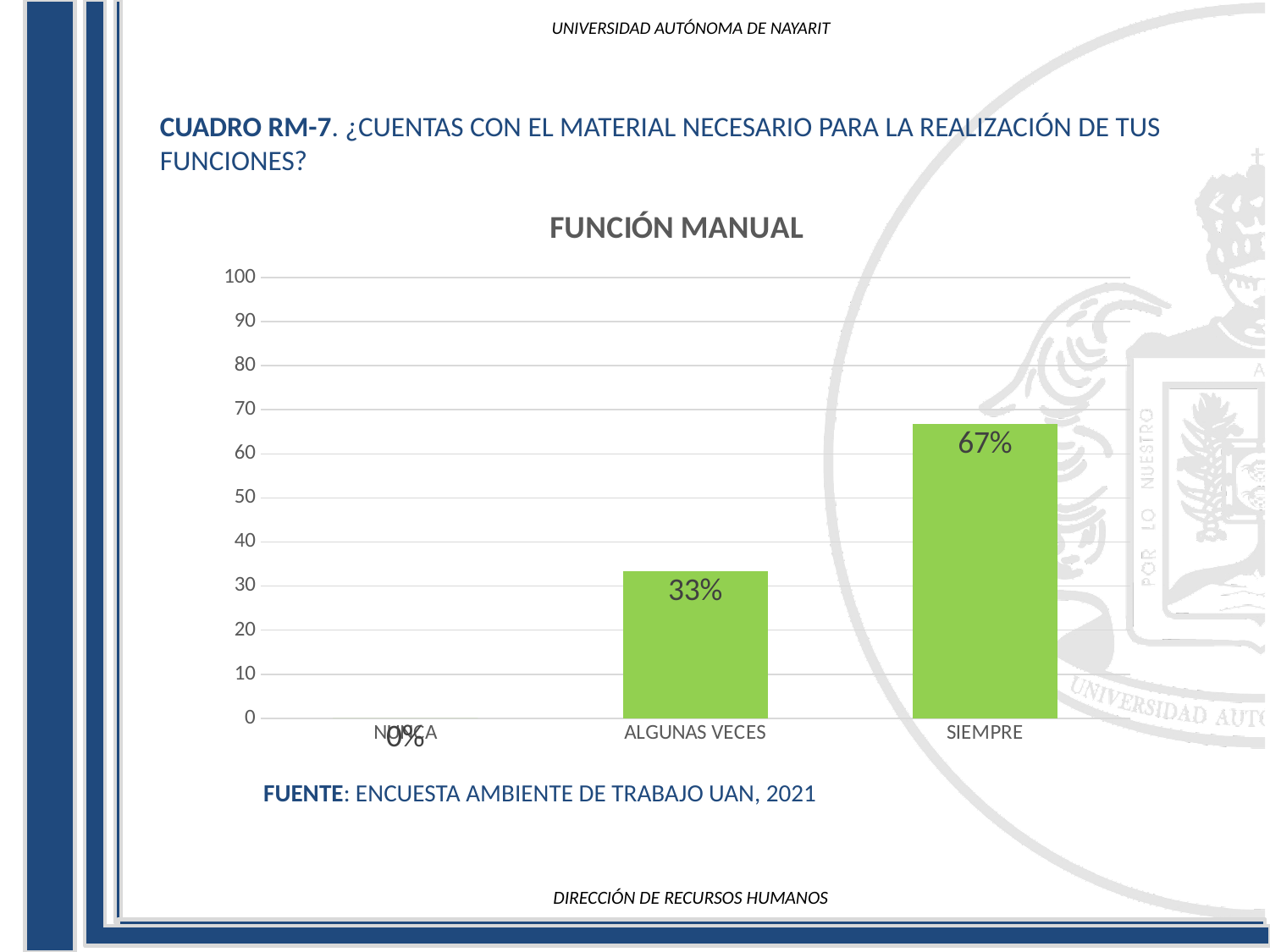
Which is larger, the value for ALGUNAS VECES or the value for SIEMPRE? SIEMPRE Is the value for SIEMPRE greater or less than 50? greater What is the title of the chart? FUNCIÓN MANUAL What is the value for NUNCA? 0% What kind of chart is shown? bar chart What is the value for SIEMPRE? 67% What is the difference between the values for SIEMPRE and ALGUNAS VECES? 34% Which category has the lowest value? NUNCA Which category has the highest value? SIEMPRE What is the value for ALGUNAS VECES? 33% How many categories are shown on the x axis? 3 Is the value for ALGUNAS VECES greater or less than 40? less